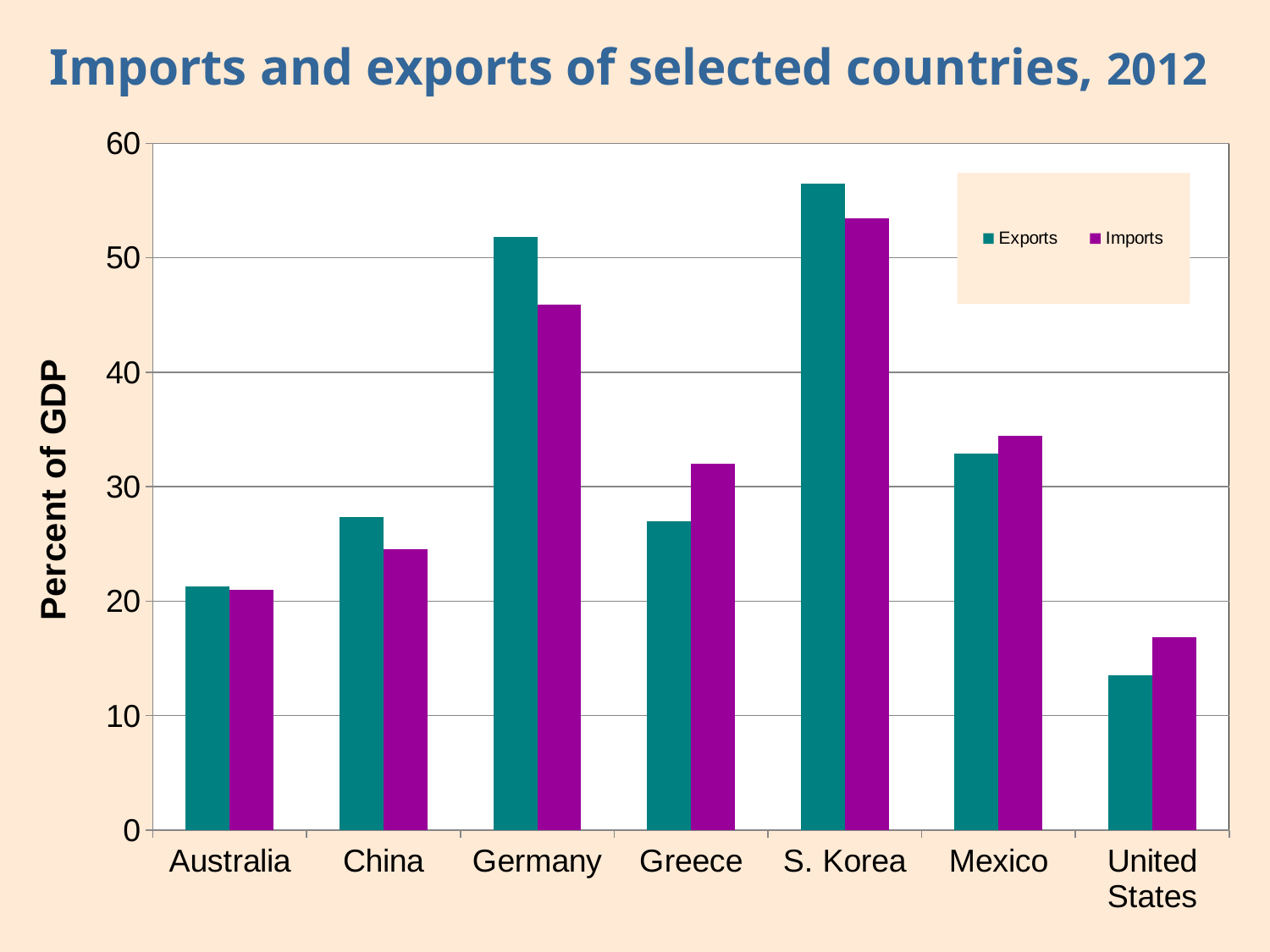
Is the Exports value for Germany greater or less than 50? greater Which country has the highest Imports value? S. Korea For Germany, which is larger, Exports or Imports? Exports Which country has the lowest Exports value? United States Which country has the highest Exports value? S. Korea How many countries are shown on the x axis? 7 What kind of chart is shown on the slide? bar chart For Greece, which is larger, Exports or Imports? Imports Is the Imports value for China greater or less than 30? less What is the label on the vertical axis? Percent of GDP Which country has the lowest Imports value? United States How many series does the legend list? 2